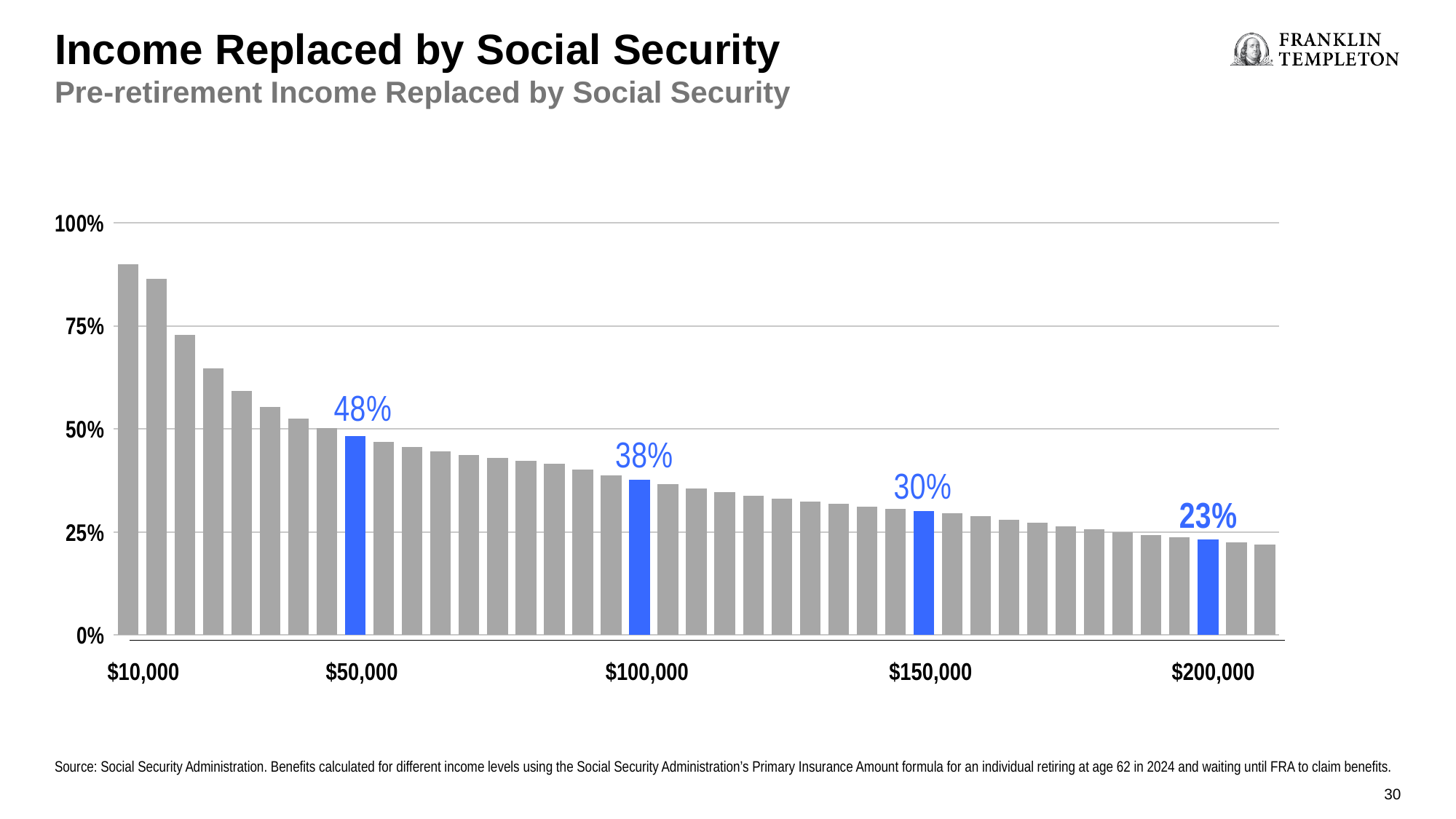
Do the replacement rates rise or fall as pre-retirement income increases along the x axis? fall What percentage of income is replaced at the $200,000 income level? 23% How many percentage points higher is the $100,000 value than the $150,000 value? 8 percentage points What percentage of pre-retirement income is replaced by Social Security at the $50,000 income level? 48% What kind of chart is shown on the slide? bar chart What colour are the highlighted bars with data labels? blue What is the difference in percentage points between the replacement rates at $50,000 and $200,000? 25 percentage points What is the replacement rate shown for the $100,000 income level? 38% Is the replacement rate for the $10,000 income level greater or less than 75%? greater What value is labeled for the $150,000 income level? 30% Which income level has the higher replacement rate, $50,000 or $200,000? $50,000 Among the four labeled values, which income level has the lowest replacement rate? $200,000